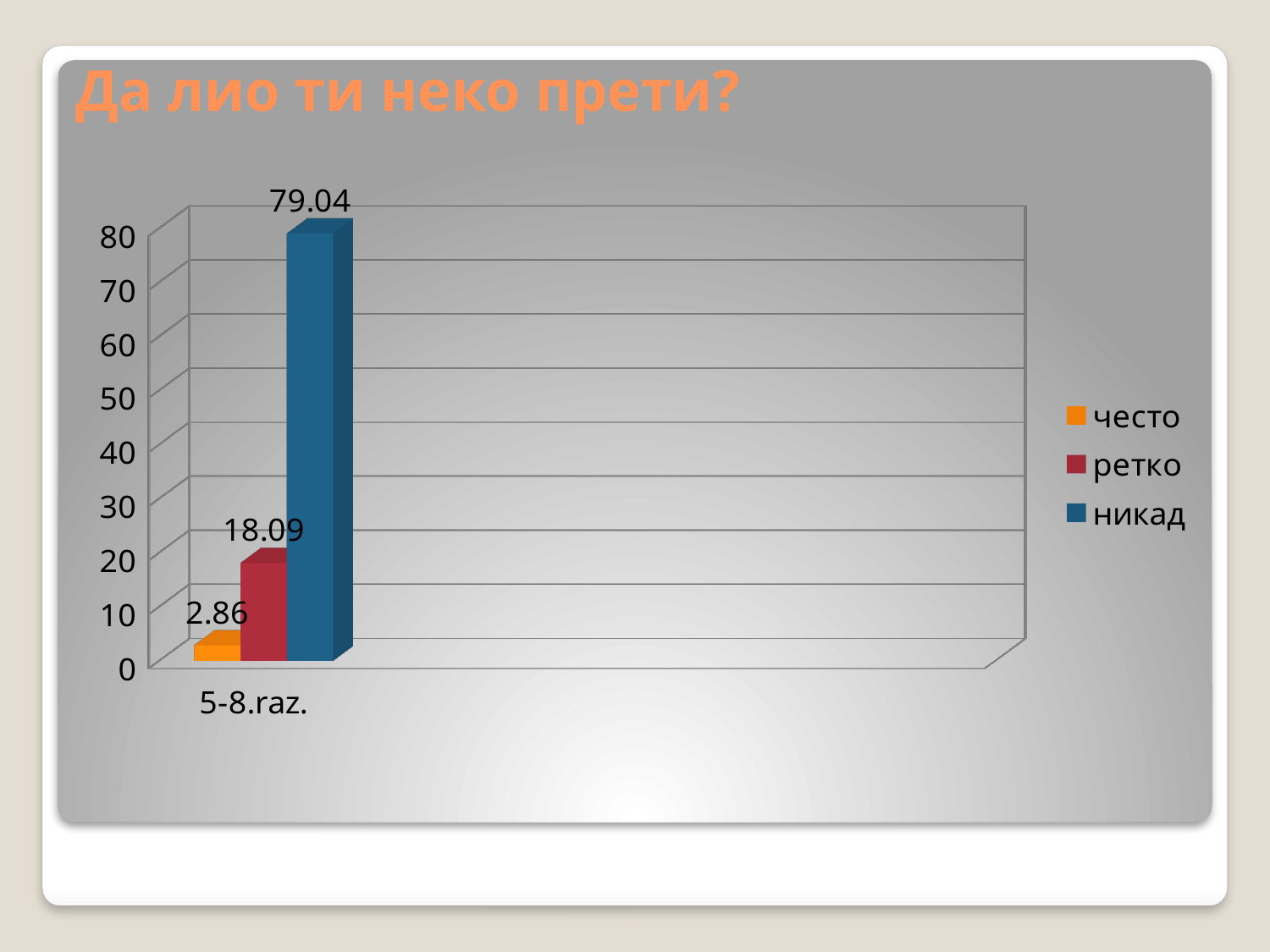
How many series does the legend list? 3 What is the value for the 'никад' series in the 5-8.raz. category? 79.04 Is the value for 'никад' greater or less than 70? greater What is the difference between the 'ретко' value and the 'често' value? 15.23 What is the value for the 'ретко' series in the 5-8.raz. category? 18.09 Which is larger, the value for 'ретко' or the value for 'често'? ретко What is the difference between the 'никад' value and the 'ретко' value? 60.95 Which series has the highest value in the chart? никад What is the value for the 'често' series in the 5-8.raz. category? 2.86 What kind of chart is shown on the slide? bar chart What is the title of the slide? Да лио ти неко прети? Which series has the lowest value in the chart? често